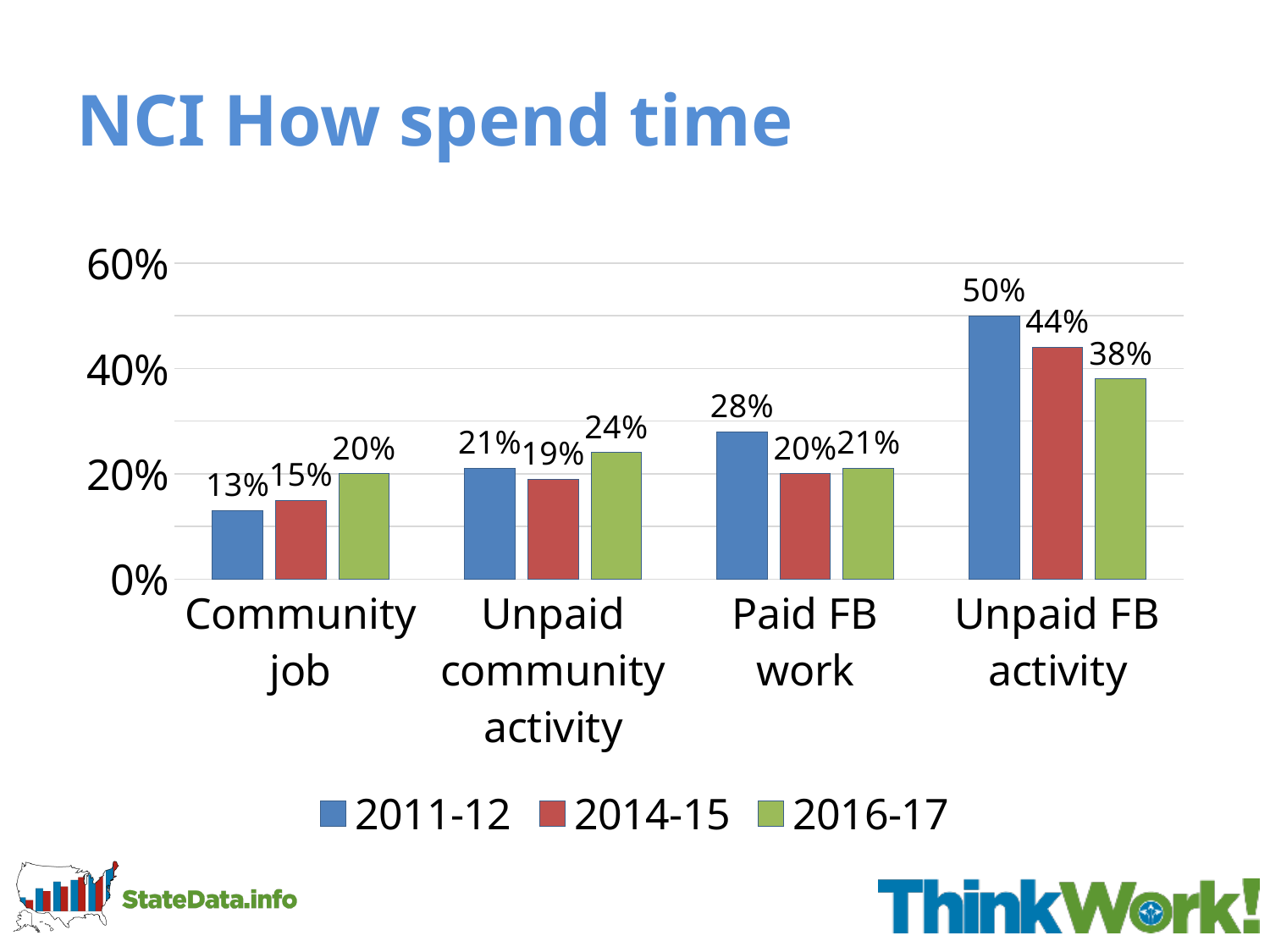
What is the value for Unpaid FB activity in 2016-17? 38% What kind of chart is shown on the slide? bar chart How many categories are shown on the x axis? 4 How many series does the legend list? 3 What is the difference between the 2011-12 and 2016-17 values for Unpaid FB activity? 12% What is the value for Community job in 2011-12? 13% Which category has the highest value in 2011-12? Unpaid FB activity Is the 2014-15 value for Unpaid FB activity greater or less than 40%? greater Which is larger for Paid FB work: the 2011-12 value or the 2016-17 value? 2011-12 What is the value for Paid FB work in 2014-15? 20% Which category has the lowest value in 2014-15? Community job Do the values for Unpaid FB activity rise or fall from 2011-12 to 2016-17? fall